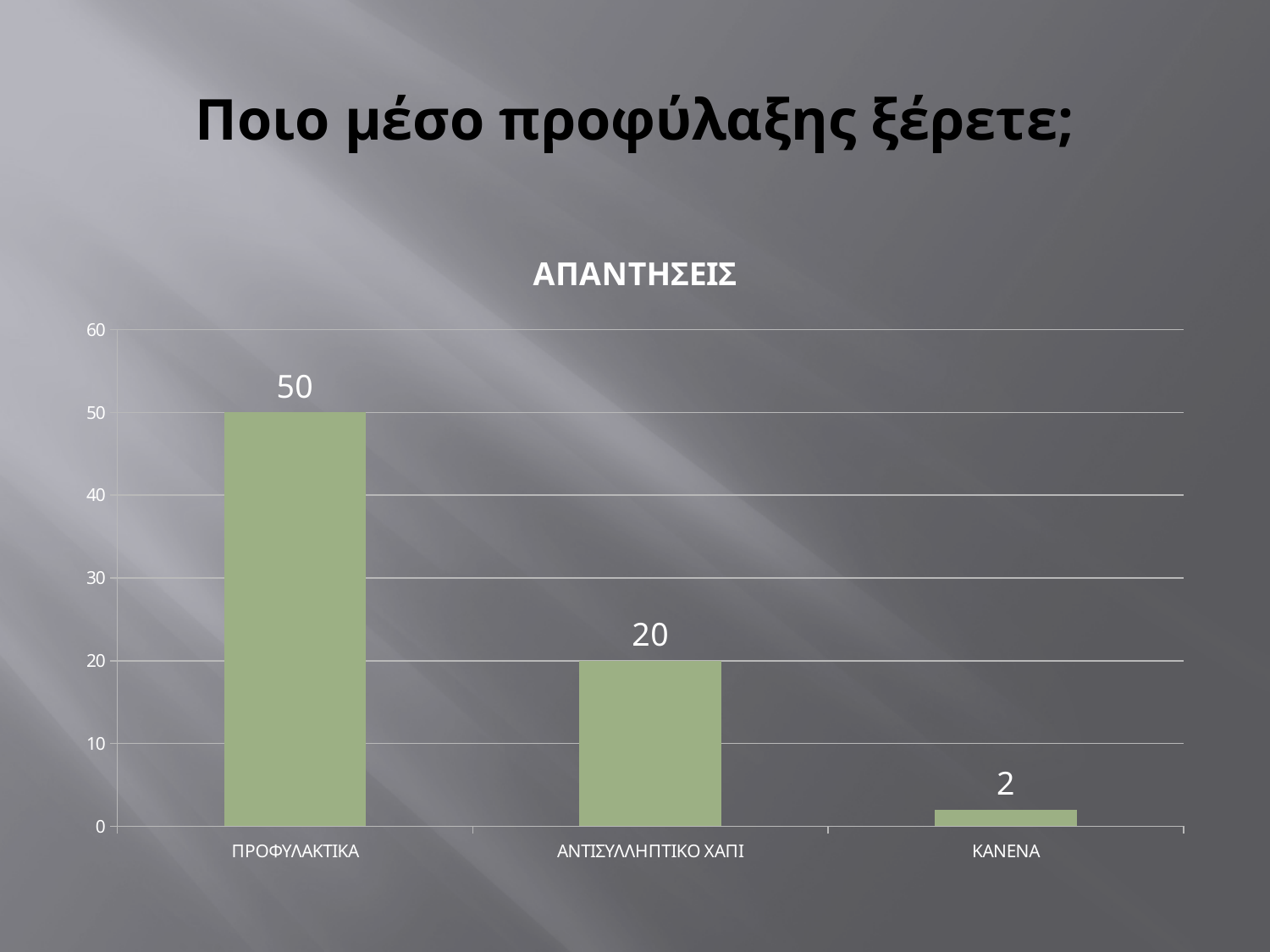
Which category has the lowest value? ΚΑΝΕΝΑ What is the difference between the values for ΑΝΤΙΣΥΛΛΗΠΤΙΚΟ ΧΑΠΙ and ΚΑΝΕΝΑ? 18 What is the value for ΠΡΟΦΥΛΑΚΤΙΚΑ? 50 What kind of chart is shown on the slide? bar chart Which category has the highest value? ΠΡΟΦΥΛΑΚΤΙΚΑ What is the difference between the values for ΠΡΟΦΥΛΑΚΤΙΚΑ and ΑΝΤΙΣΥΛΛΗΠΤΙΚΟ ΧΑΠΙ? 30 Which is larger, the value for ΑΝΤΙΣΥΛΛΗΠΤΙΚΟ ΧΑΠΙ or the value for ΚΑΝΕΝΑ? ΑΝΤΙΣΥΛΛΗΠΤΙΚΟ ΧΑΠΙ How many categories are shown on the x axis? 3 What is the value for ΑΝΤΙΣΥΛΛΗΠΤΙΚΟ ΧΑΠΙ? 20 What is the title of the chart? ΑΠΑΝΤΗΣΕΙΣ Is the value for ΠΡΟΦΥΛΑΚΤΙΚΑ greater or less than 40? greater What is the value for ΚΑΝΕΝΑ? 2